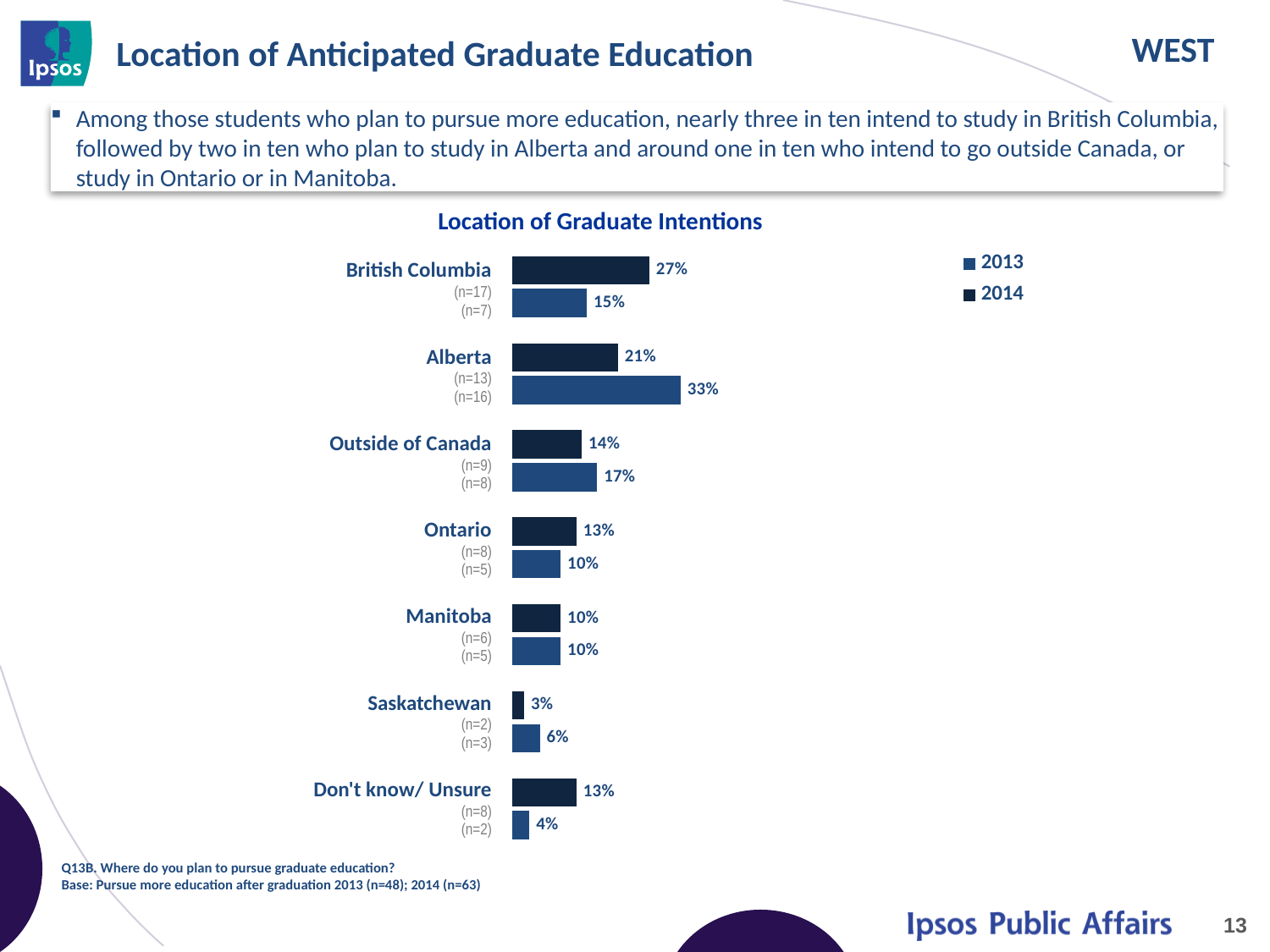
Which category has the highest 2014 value? Alberta What is the difference between the 2013 and 2014 values for British Columbia? 12% Which category has the lowest 2013 value? Saskatchewan What is the 2013 value for British Columbia? 27% What is the title of the chart? Location of Graduate Intentions What kind of chart is shown on the slide? Bar chart Which is larger for Ontario, the 2013 value or the 2014 value? 2013 What is the 2014 value for Outside of Canada? 17% What is the 2014 value for Alberta? 33% What is the 2013 value for Don't know/ Unsure? 13% How many series does the legend list? 2 How many categories are shown in the chart? 7